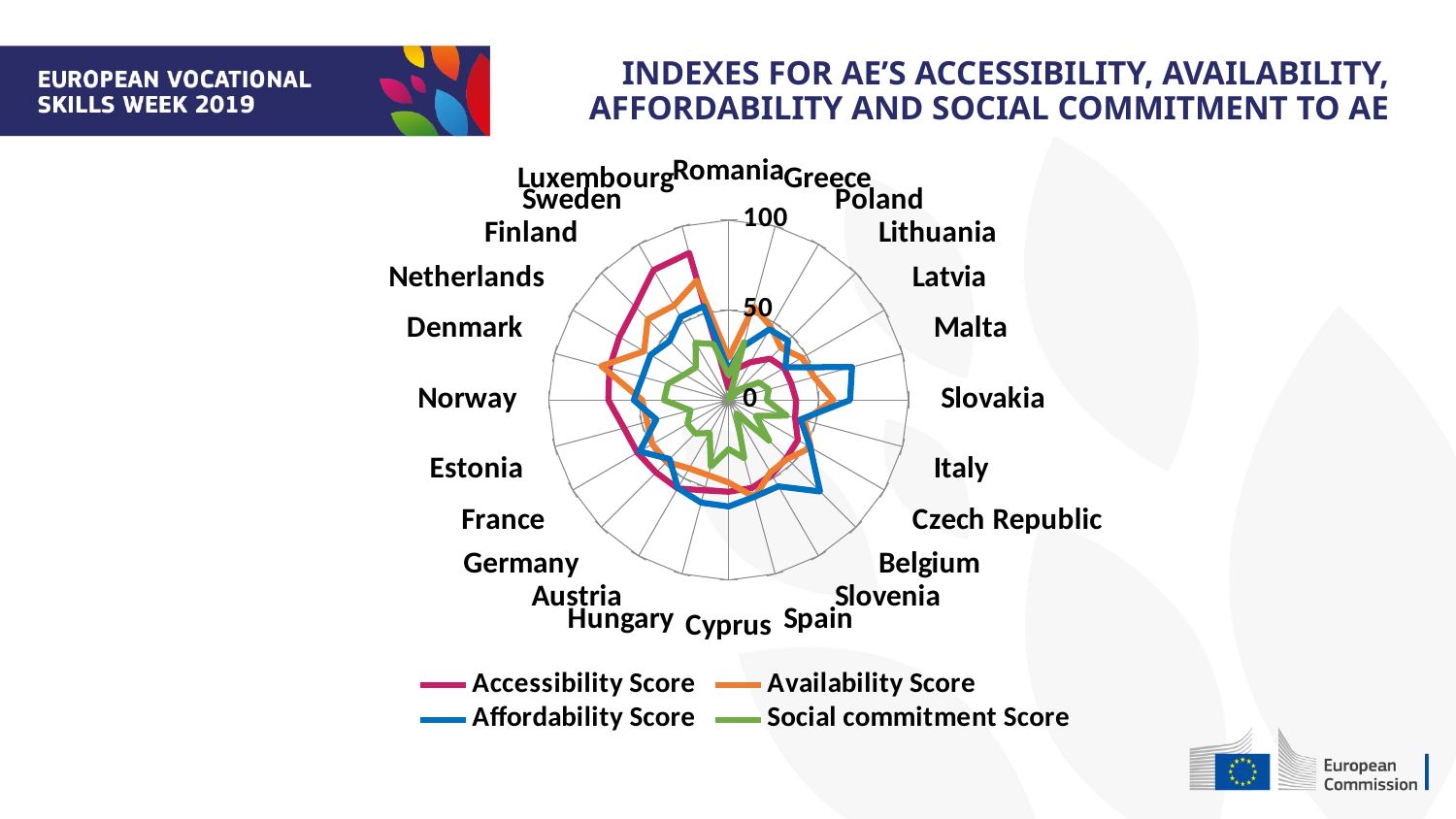
Is the Accessibility Score for Sweden greater or less than 50? greater Is the Affordability Score for Italy greater or less than 50? less What is the maximum value shown on the radar chart's axis? 100 Is the Social commitment Score for Slovakia greater or less than 50? less What kind of chart is shown on the slide? Radar chart Which colour represents the Social commitment Score in the legend? Green How many series does the legend list? 4 How many countries are plotted around the radar chart? 24